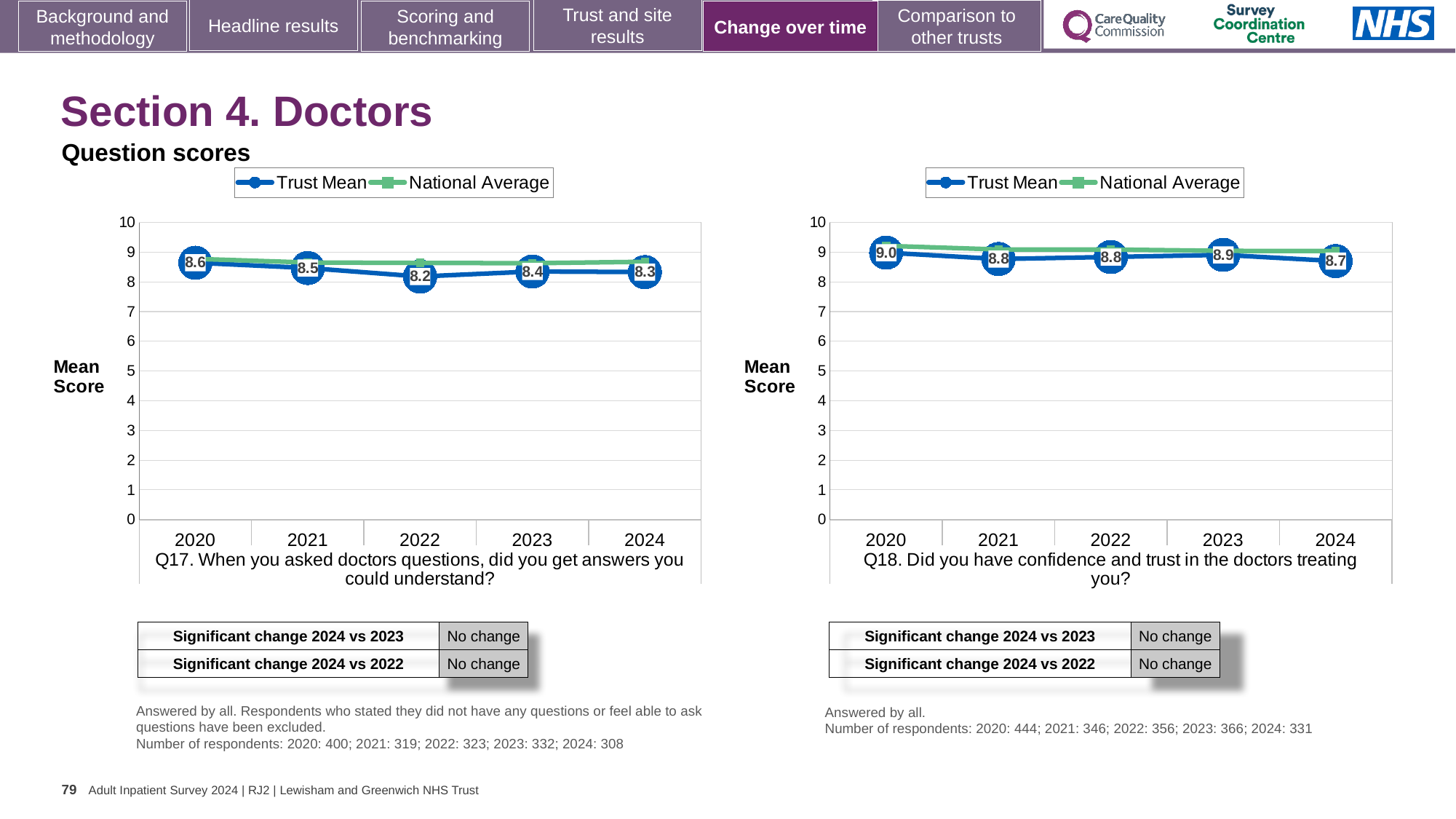
In the Q17 chart on the left, which year has the lowest Trust Mean score? 2022 In the Q17 chart on the left, which year has the highest Trust Mean score? 2020 What type of chart is the Q17 chart on the left? Line chart In the Q18 chart on the right, is the Trust Mean score higher in 2023 or in 2024? 2023 In the Q17 chart on the left, what is the difference between the Trust Mean scores for 2020 and 2022? 0.4 In the Q17 chart on the left, is the National Average value for 2022 greater or less than 8? greater In the Q17 chart on the left, what is the Trust Mean score for 2022? 8.2 In the Q18 chart on the right, what is the difference between the Trust Mean scores for 2020 and 2024? 0.3 How many years are plotted on the x axis of the Q18 chart on the right? 5 In the Q18 chart on the right, which year has the lowest Trust Mean score? 2024 How many series does the legend of the Q17 chart on the left list? 2 In the Q18 chart on the right, what is the Trust Mean score for 2020? 9.0